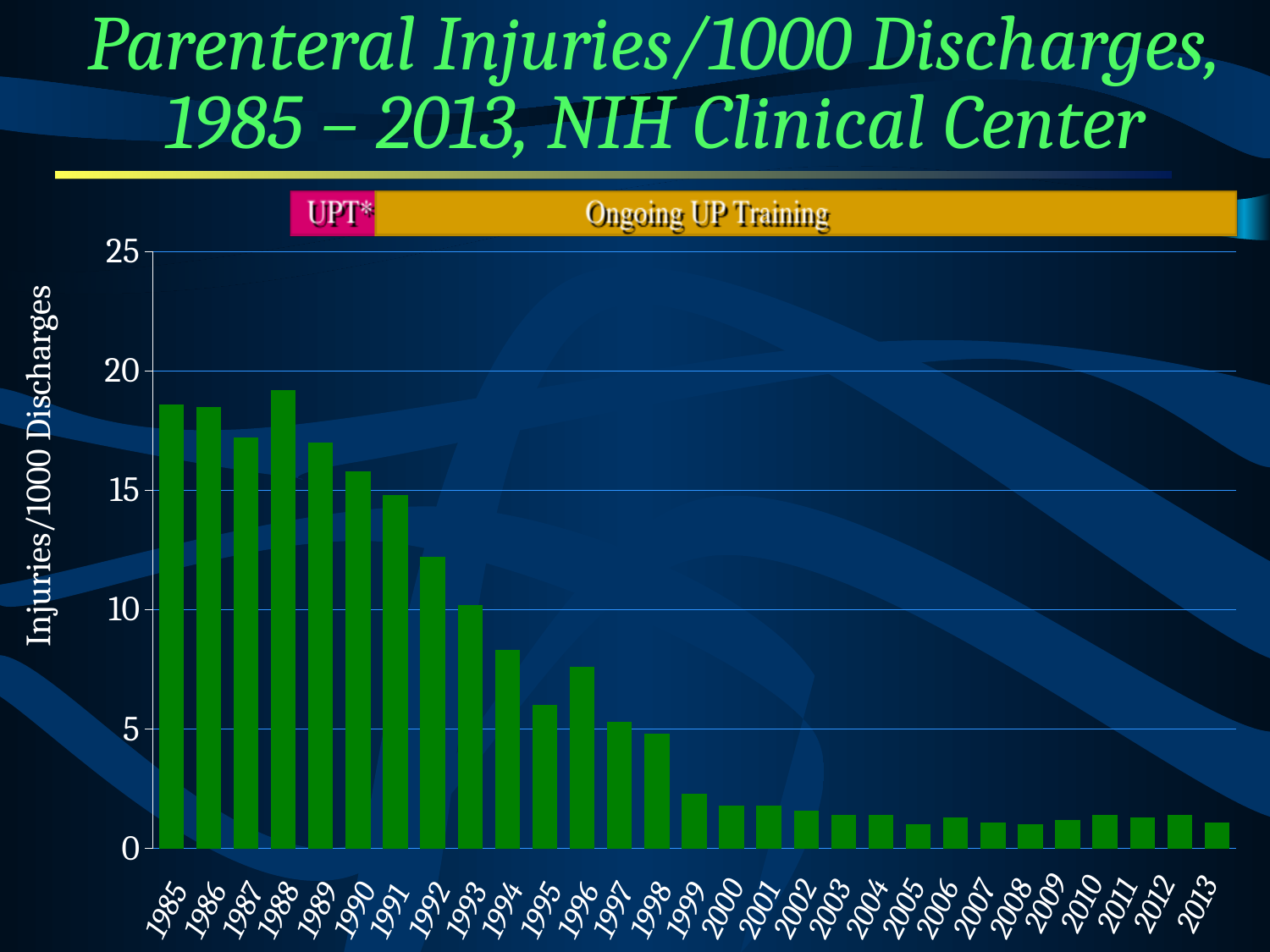
What is the label on the vertical axis of the chart? Injuries/1000 Discharges Is the value for 1994 greater or less than 10? less Is the value for 1990 greater or less than 15? greater Is the value for 1992 greater or less than 10? greater Which year has the highest number of parenteral injuries per 1000 discharges? 1988 Do the values generally rise or fall from 1985 to 2013? fall What kind of chart is shown on the slide? bar chart Which year has the larger value, 1992 or 1995? 1992 How many years (bars) are plotted on the chart? 29 Which year has the larger value, 1985 or 2013? 1985